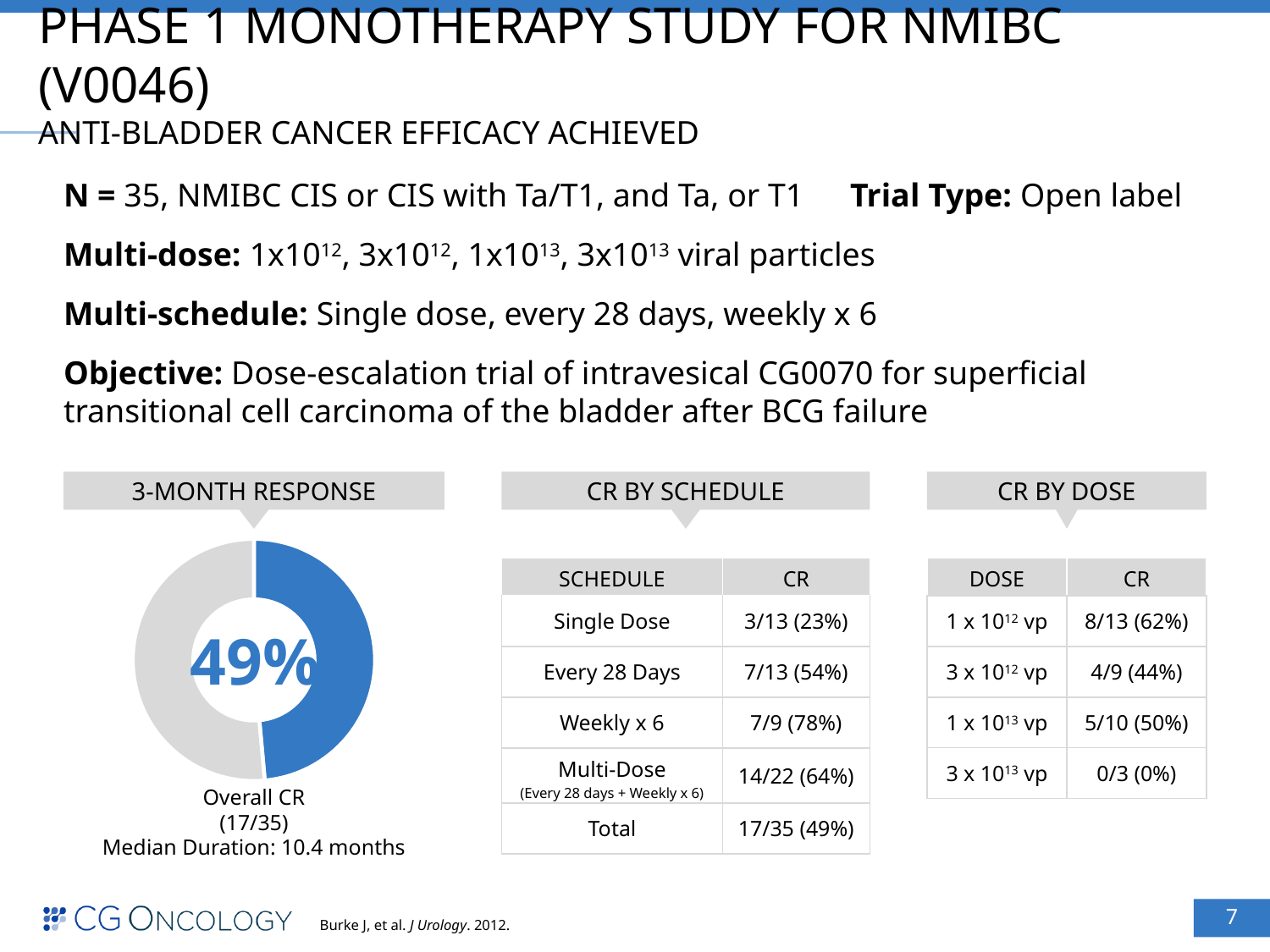
What kind of chart is shown under the "3-MONTH RESPONSE" heading? Donut (pie) chart Is the blue segment of the 3-MONTH RESPONSE donut chart greater or less than 50%? less What median duration is stated below the 3-MONTH RESPONSE donut chart? 10.4 months What fraction is given below the 3-MONTH RESPONSE donut chart for the Overall CR? 17/35 What percentage is printed in the centre of the 3-MONTH RESPONSE donut chart? 49% What share of the 3-MONTH RESPONSE donut chart does the blue segment represent? 49% What label appears directly below the 3-MONTH RESPONSE donut chart? Overall CR How many segments does the 3-MONTH RESPONSE donut chart have? 2 Which colour is used for the Overall CR segment in the 3-MONTH RESPONSE donut chart? Blue